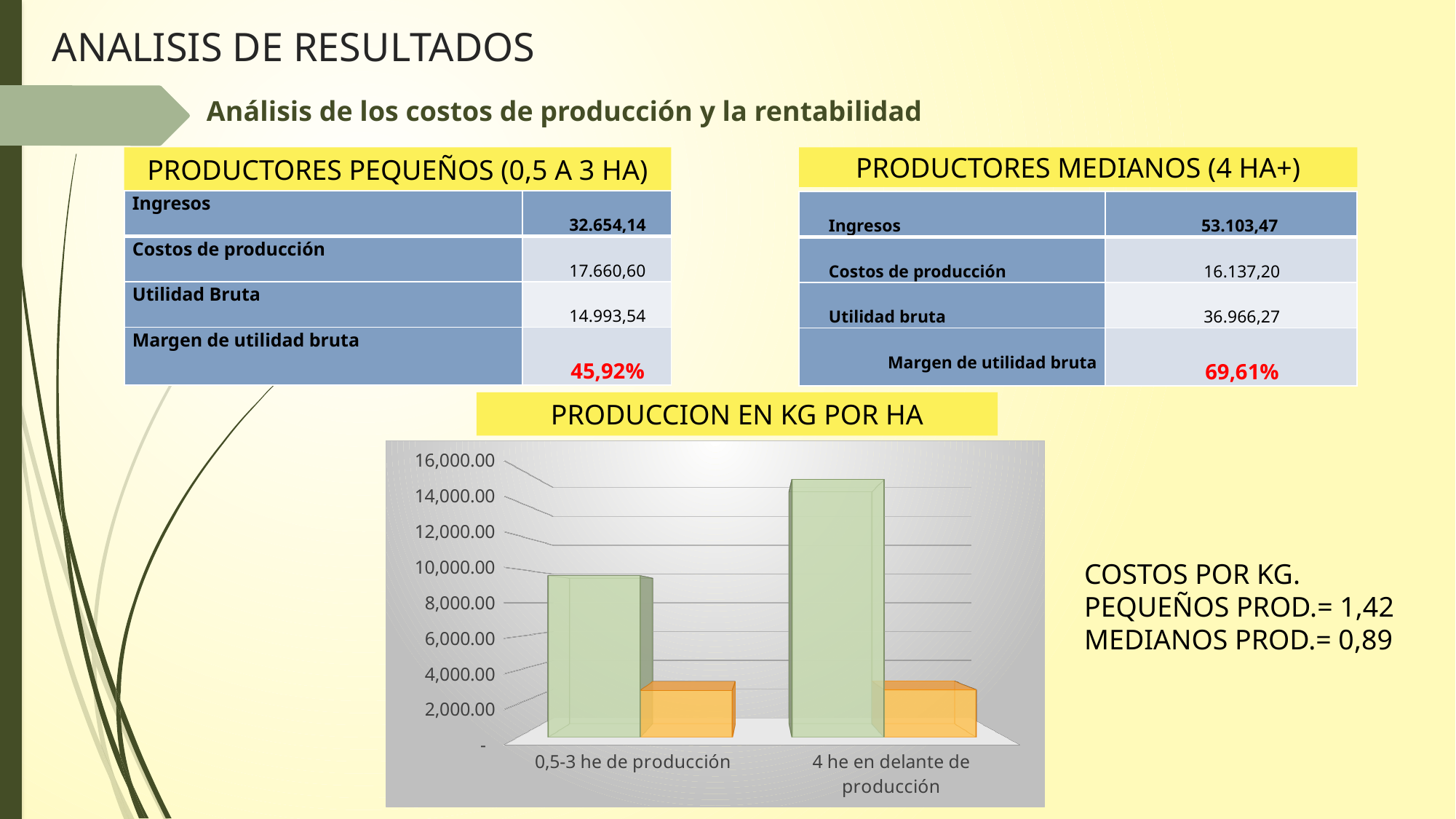
What kind of chart is shown under the title PRODUCCION EN KG POR HA? bar chart In the PRODUCCION EN KG POR HA chart, which category has the taller green bar, '0,5-3 he de producción' or '4 he en delante de producción'? 4 he en delante de producción In the PRODUCCION EN KG POR HA chart, is the green bar for '0,5-3 he de producción' greater or less than 12,000.00? less In the PRODUCCION EN KG POR HA chart, is the green bar for '0,5-3 he de producción' greater or less than 8,000.00? greater How many categories are shown on the x axis of the PRODUCCION EN KG POR HA chart? 2 How many bars are plotted in total in the PRODUCCION EN KG POR HA chart? 4 In the PRODUCCION EN KG POR HA chart, is the green bar for '4 he en delante de producción' greater or less than 14,000.00? greater What is the title shown above the bar chart on the slide? PRODUCCION EN KG POR HA In the PRODUCCION EN KG POR HA chart, do the green bars rise or fall from the first category to the second? rise What is the highest tick value shown on the vertical axis of the PRODUCCION EN KG POR HA chart? 16,000.00